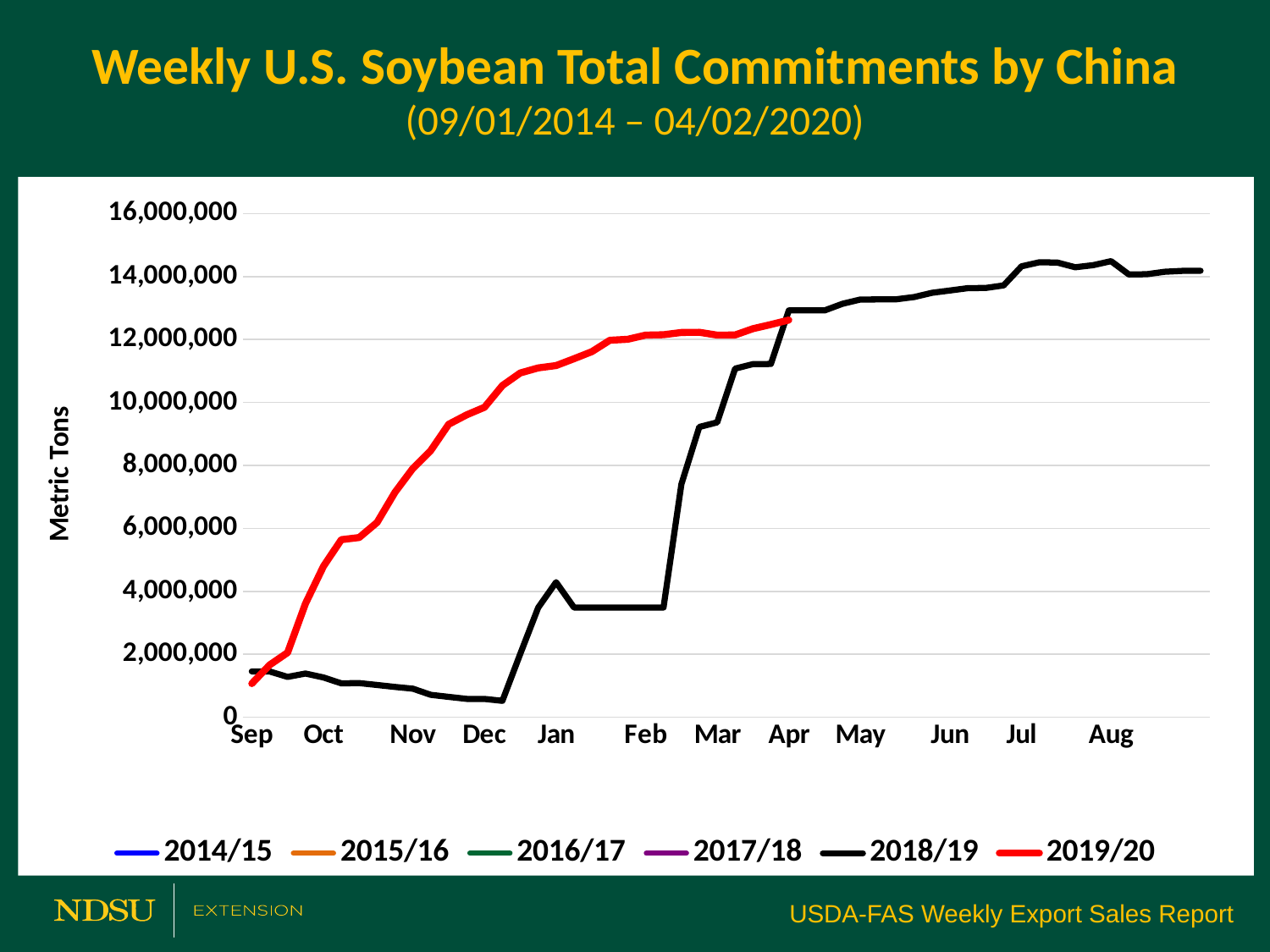
Is the value for 2019/20 at Jan greater or less than 10,000,000 metric tons? greater Does the 2019/20 line rise or fall from Sep to Apr? Rise What colour is the line for the 2019/20 series? Red What kind of chart is shown on the slide? Line chart Is the value for 2018/19 at Feb greater or less than 4,000,000 metric tons? less At Jan, which series has the larger value, 2018/19 or 2019/20? 2019/20 How many series does the legend list? 6 Is the value for 2019/20 at Oct greater or less than 4,000,000 metric tons? greater What is the label on the y axis? Metric Tons How many month labels are shown along the x axis? 12